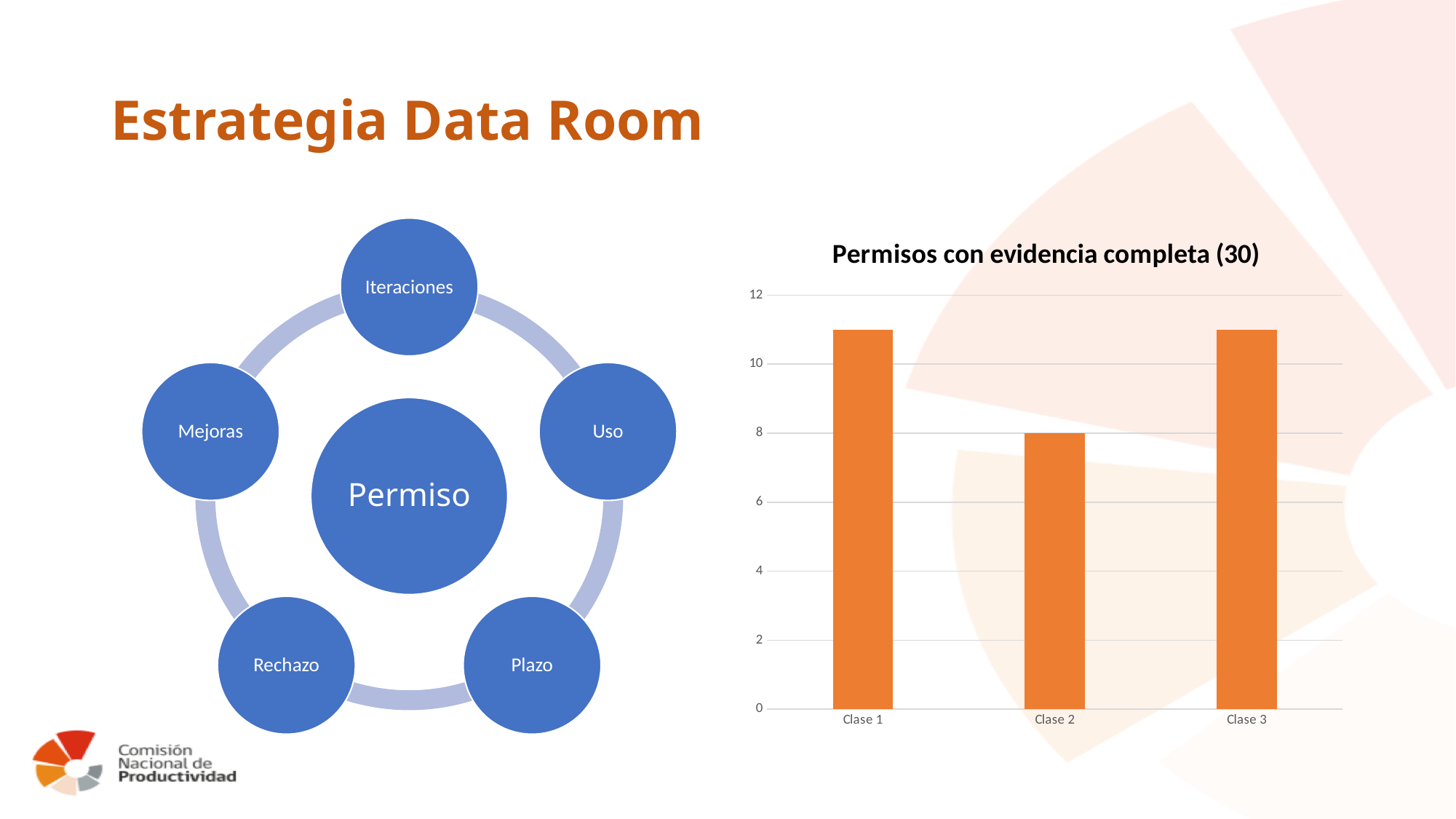
What is the value for Clase 2 in the chart 'Permisos con evidencia completa (30)'? 8 Which category has the lowest value in the chart 'Permisos con evidencia completa (30)'? Clase 2 Which is larger, the value for Clase 1 or the value for Clase 2? Clase 1 Which is larger, the value for Clase 2 or the value for Clase 3? Clase 3 What kind of chart is shown on the slide? bar chart What is the highest value shown on the chart's vertical axis? 12 Is the value for Clase 1 greater or less than 10? greater What is the title of the chart on the slide? Permisos con evidencia completa (30) Is the value for Clase 2 greater or less than 10? less Is the value for Clase 3 greater or less than 10? greater How many categories are shown on the x axis of the chart? 3